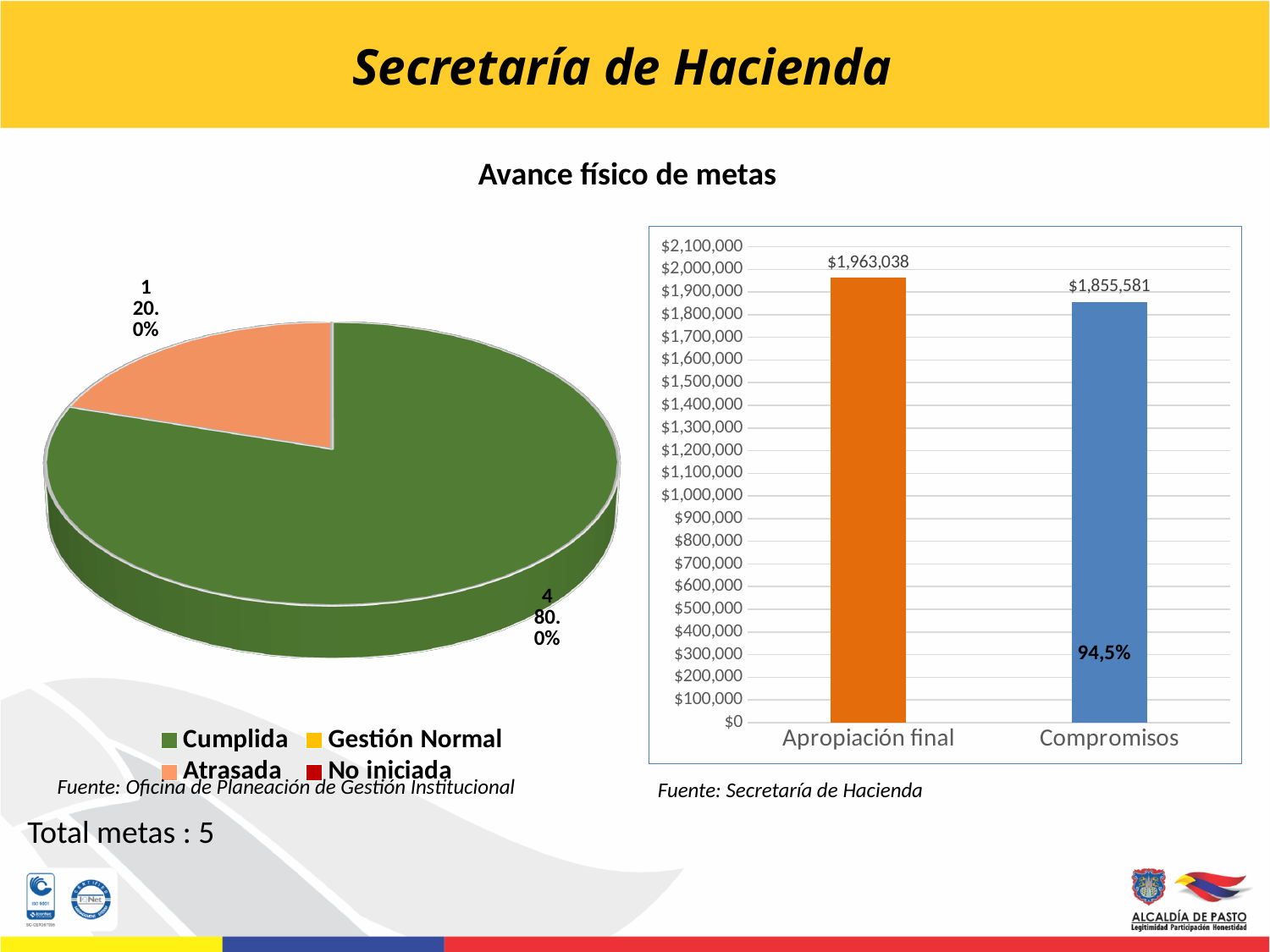
In the pie chart on the left, how many metas are in the Cumplida slice? 4 In the pie chart on the left, what share of the pie does the Cumplida slice represent? 80.0% How many entries does the legend of the pie chart on the left list? 4 In the bar chart on the right, which category has the higher value, Apropiación final or Compromisos? Apropiación final In the pie chart on the left, what share of the pie does the Atrasada slice represent? 20.0% What kind of chart is shown on the right side of the slide? Bar chart In the bar chart on the right, how many bars are plotted? 2 In the bar chart on the right, what percentage label is shown on the Compromisos bar? 94,5% In the bar chart on the right, is the value for Compromisos greater or less than $1,800,000? greater In the bar chart on the right, what is the difference between Apropiación final and Compromisos? $107,457 In the bar chart on the right, what is the value for Compromisos? $1,855,581 In the bar chart on the right, what is the value for Apropiación final? $1,963,038